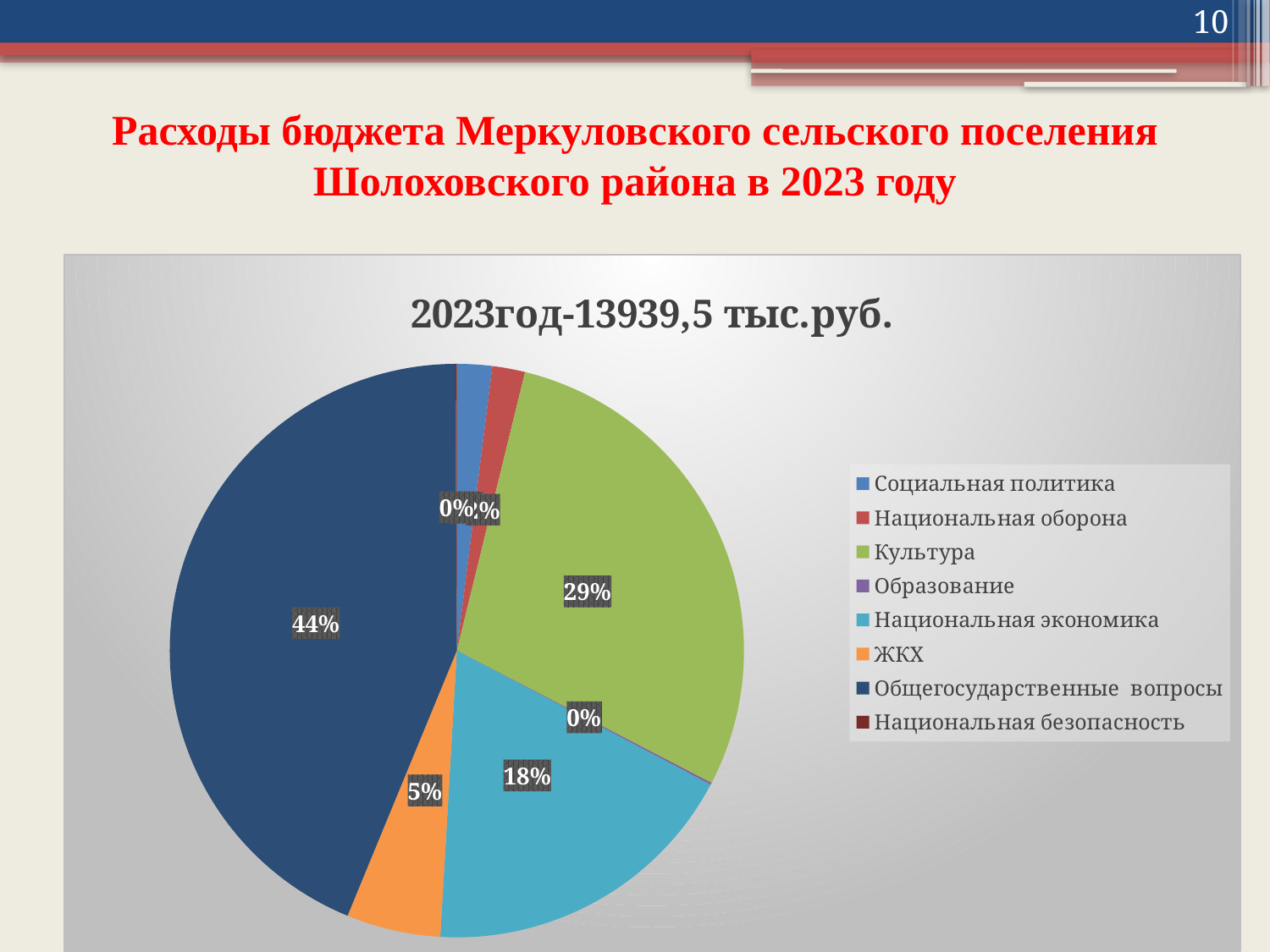
By how many percentage points does the share for Общегосударственные вопросы exceed the share for Культура? 15 Which is larger, the share for Культура or the share for Национальная экономика? Культура Which is larger, the share for ЖКХ or the share for Национальная экономика? Национальная экономика How many entries does the chart legend list? 8 What is the title of the chart? 2023год-13939,5 тыс.руб. What share of the pie does Национальная экономика have? 18% What share of the pie does ЖКХ have? 5% What kind of chart is shown on the slide? pie chart What share of the pie does Общегосударственные вопросы have? 44% Which category has the largest share of the pie? Общегосударственные вопросы